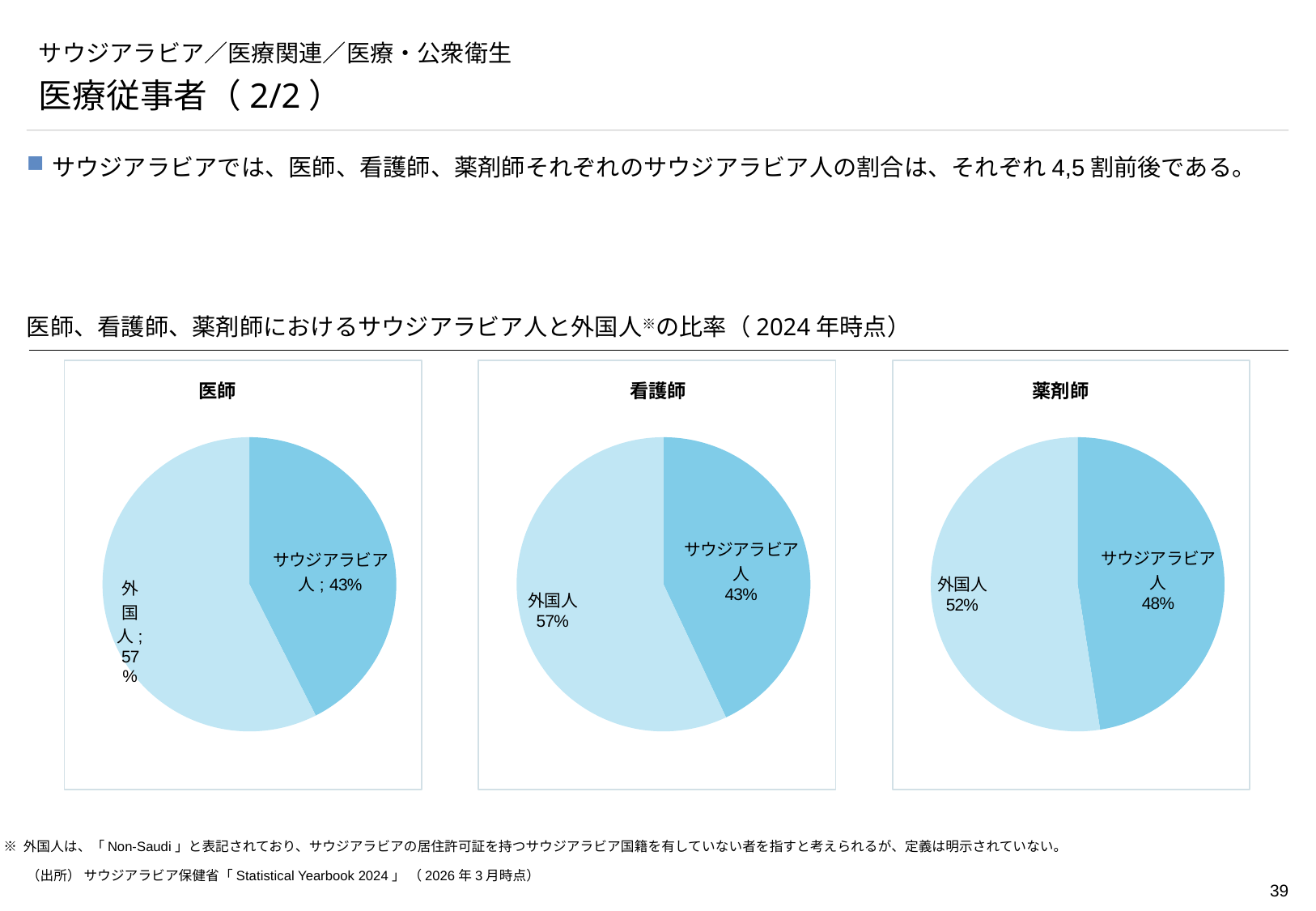
In the 医師 pie chart, what share is 外国人? 57% In the 薬剤師 pie chart, what share is 外国人? 52% In the 薬剤師 pie chart, which slice is larger, サウジアラビア人 or 外国人? 外国人 In the 薬剤師 pie chart, what share is サウジアラビア人? 48% In the 薬剤師 pie chart, what is the difference in percentage points between 外国人 and サウジアラビア人? 4 In the 医師 pie chart, what share is サウジアラビア人? 43% In the 看護師 pie chart, which slice is the largest? 外国人 How many slices does the 医師 pie chart have? 2 In the 医師 pie chart, what is the difference in percentage points between 外国人 and サウジアラビア人? 14 What kind of chart is used for 看護師? Pie chart In the 看護師 pie chart, what share is 外国人? 57% How many pie charts are shown on the slide? 3